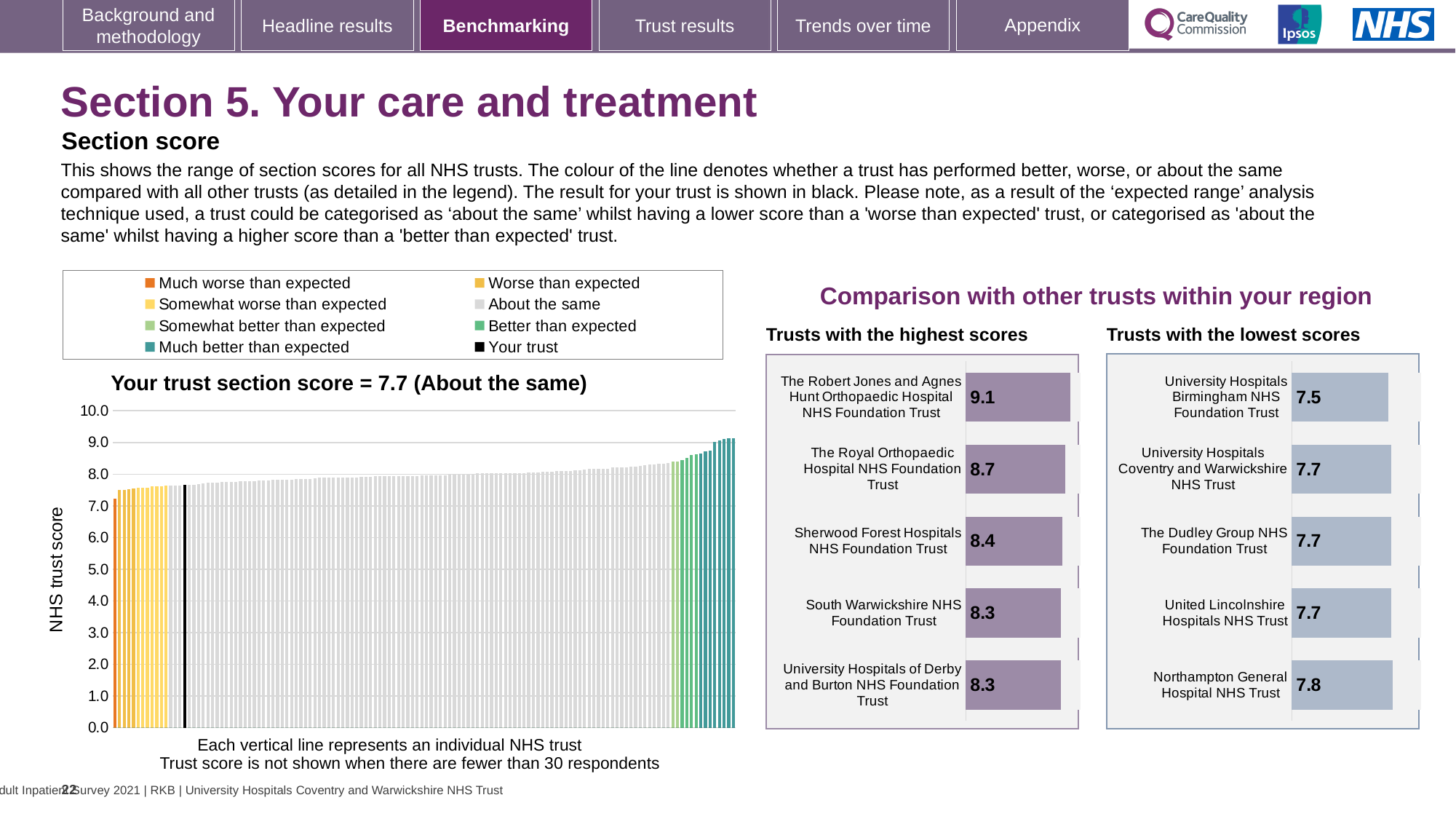
In the 'Trusts with the lowest scores' chart, what is the score for Northampton General Hospital NHS Trust? 7.8 In the 'Trusts with the highest scores' chart, what is the score for The Robert Jones and Agnes Hunt Orthopaedic Hospital NHS Foundation Trust? 9.1 In the 'Your trust section score' chart, what kind of chart is shown? bar chart In the 'Trusts with the lowest scores' chart, which trust has the lowest score? University Hospitals Birmingham NHS Foundation Trust In the 'Your trust section score' chart, what is the section score for your trust? 7.7 In the 'Your trust section score' chart, is the value of the black bar (your trust) greater or less than 8.0? less In the 'Trusts with the highest scores' chart, what is the difference between the scores of The Robert Jones and Agnes Hunt Orthopaedic Hospital NHS Foundation Trust and The Royal Orthopaedic Hospital NHS Foundation Trust? 0.4 In the 'Trusts with the lowest scores' chart, which has the larger score: Northampton General Hospital NHS Trust or University Hospitals Birmingham NHS Foundation Trust? Northampton General Hospital NHS Trust In the 'Trusts with the highest scores' chart, which trust has the highest score? The Robert Jones and Agnes Hunt Orthopaedic Hospital NHS Foundation Trust In the 'Your trust section score' chart, do the bar heights rise or fall from left to right? rise In the 'Your trust section score' chart, what is the label on the vertical axis? NHS trust score In the 'Trusts with the highest scores' chart, how many trusts are listed? 5